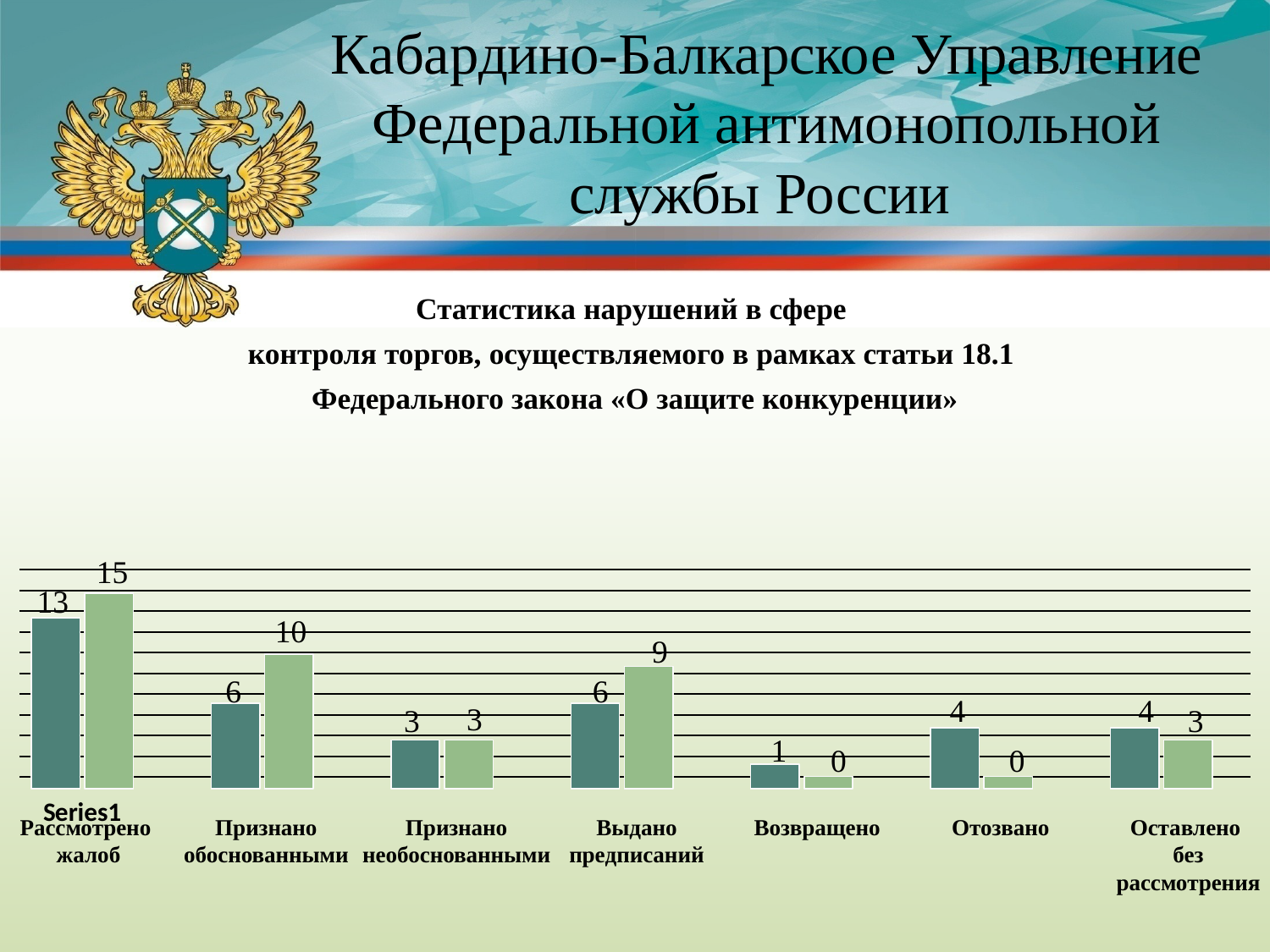
What is the value of the dark teal (first) bar for «Отозвано»? 4 What is the difference between the light green and dark teal bars for «Признано обоснованными»? 4 What type of chart is shown on the slide? bar chart How many categories are shown along the x axis of the chart? 7 What is the value of the light green (second) bar for «Признано обоснованными»? 10 Which category has the lowest value among the dark teal (first) bars? Возвращено What is the value of the dark teal (first) bar for «Рассмотрено жалоб»? 13 What is the total of the two bars for «Выдано предписаний»? 15 Which category has the highest value among the light green (second) bars? Рассмотрено жалоб What is the value of the light green (second) bar for «Рассмотрено жалоб»? 15 What is the value of the light green (second) bar for «Выдано предписаний»? 9 For «Оставлено без рассмотрения», which bar is larger, the dark teal (first) or the light green (second)? dark teal (first)